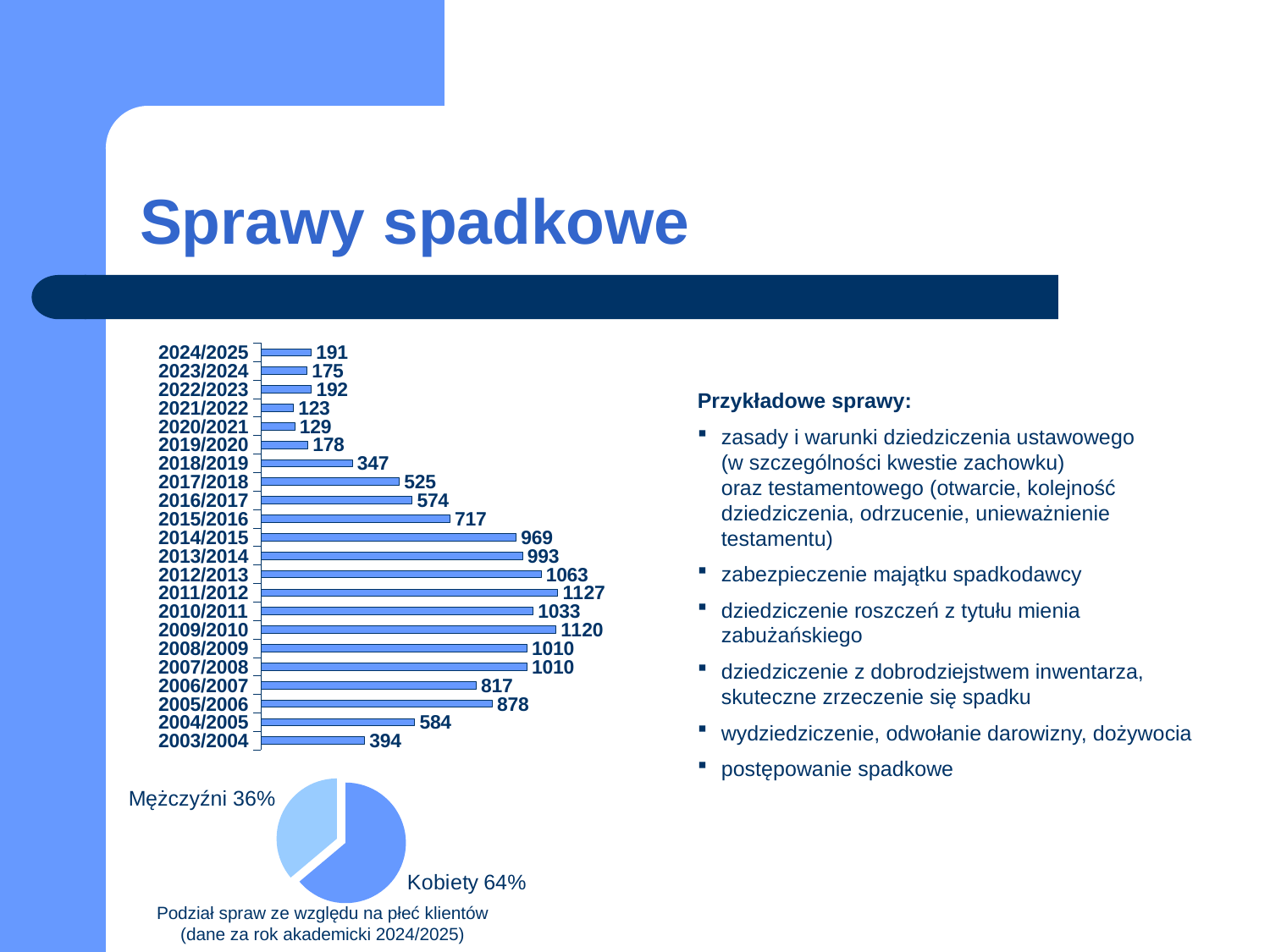
What kind of chart is the chart at the top left of the slide? bar chart In the bar chart, which academic year has the lowest value? 2021/2022 In the bar chart, what is the value for 2003/2004? 394 How many academic years are shown in the bar chart? 22 In the pie chart, what share is labelled Mężczyźni? 36% What kind of chart is the chart at the bottom left of the slide? pie chart In the bar chart, what is the value for 2011/2012? 1127 In the bar chart, which academic year has the highest value? 2011/2012 In the bar chart, what is the difference between the values for 2012/2013 and 2013/2014? 70 In the bar chart, which is larger, the value for 2016/2017 or the value for 2017/2018? 2016/2017 In the pie chart, what share is labelled Kobiety? 64% In the bar chart, what is the value for 2024/2025? 191